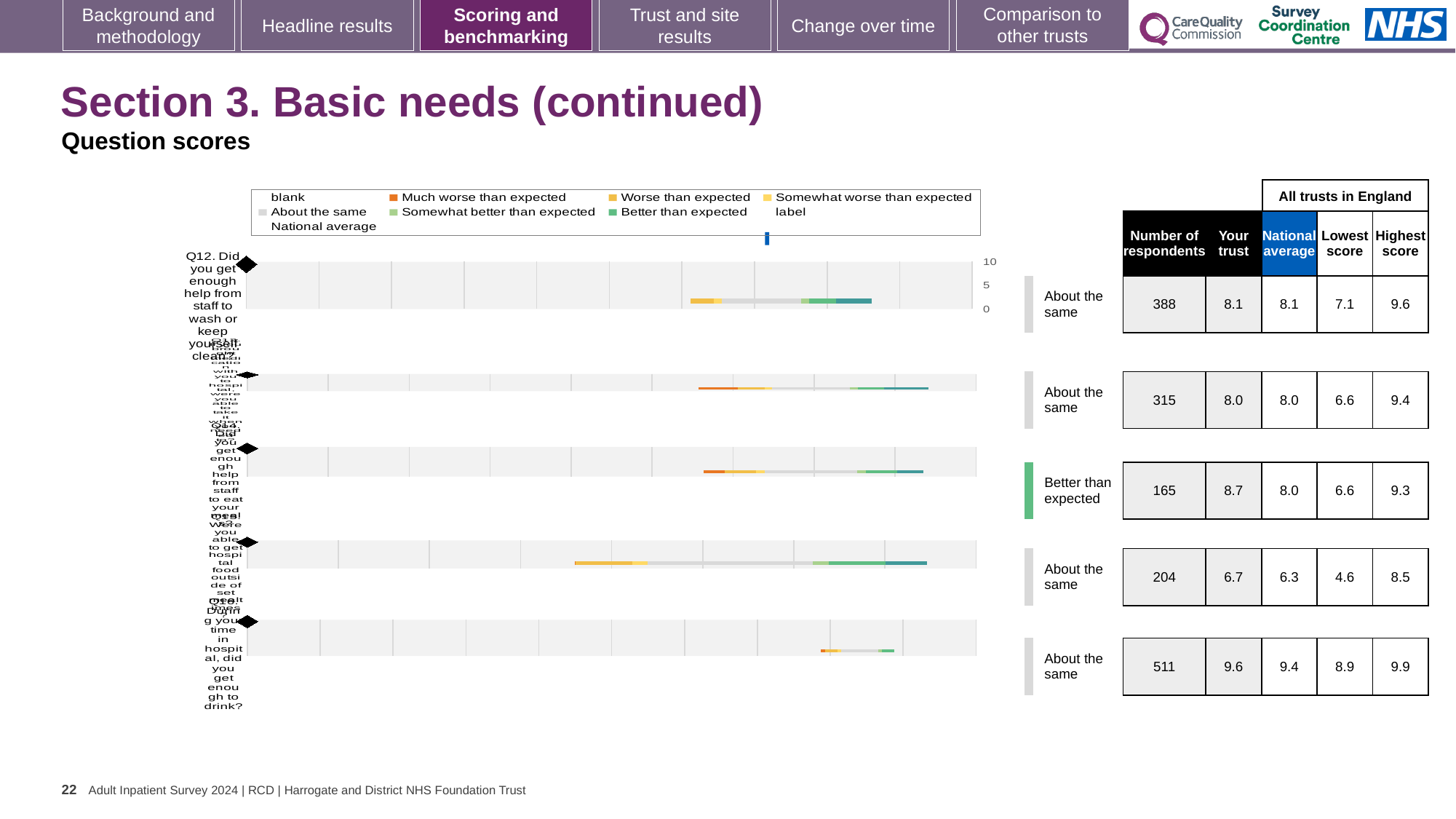
What is the difference between the 'Your trust' score and the national average for the third row (rated 'Better than expected')? 0.7 What is the lowest score across all trusts in England for the fifth (bottom) row? 8.9 What is the national average for the third row, the one rated 'Better than expected'? 8.0 What kind of chart is shown on the slide? bar chart How many question rows (bars) does the chart show? 5 How many of the five rows are rated 'About the same'? 4 For the fourth row, is the 'Your trust' score (6.7) or the national average (6.3) larger? Your trust (6.7) What is the 'Your trust' score for Q12 (the first row) in the table next to the chart? 8.1 Which row has the lowest 'Your trust' score, and what is it? The fourth row, 6.7 What is the 'Your trust' score for the third row, the one rated 'Better than expected'? 8.7 How many respondents are listed for Q12 (the first row)? 388 Which row has the highest 'Your trust' score, and what is it? The fifth (bottom) row, 9.6